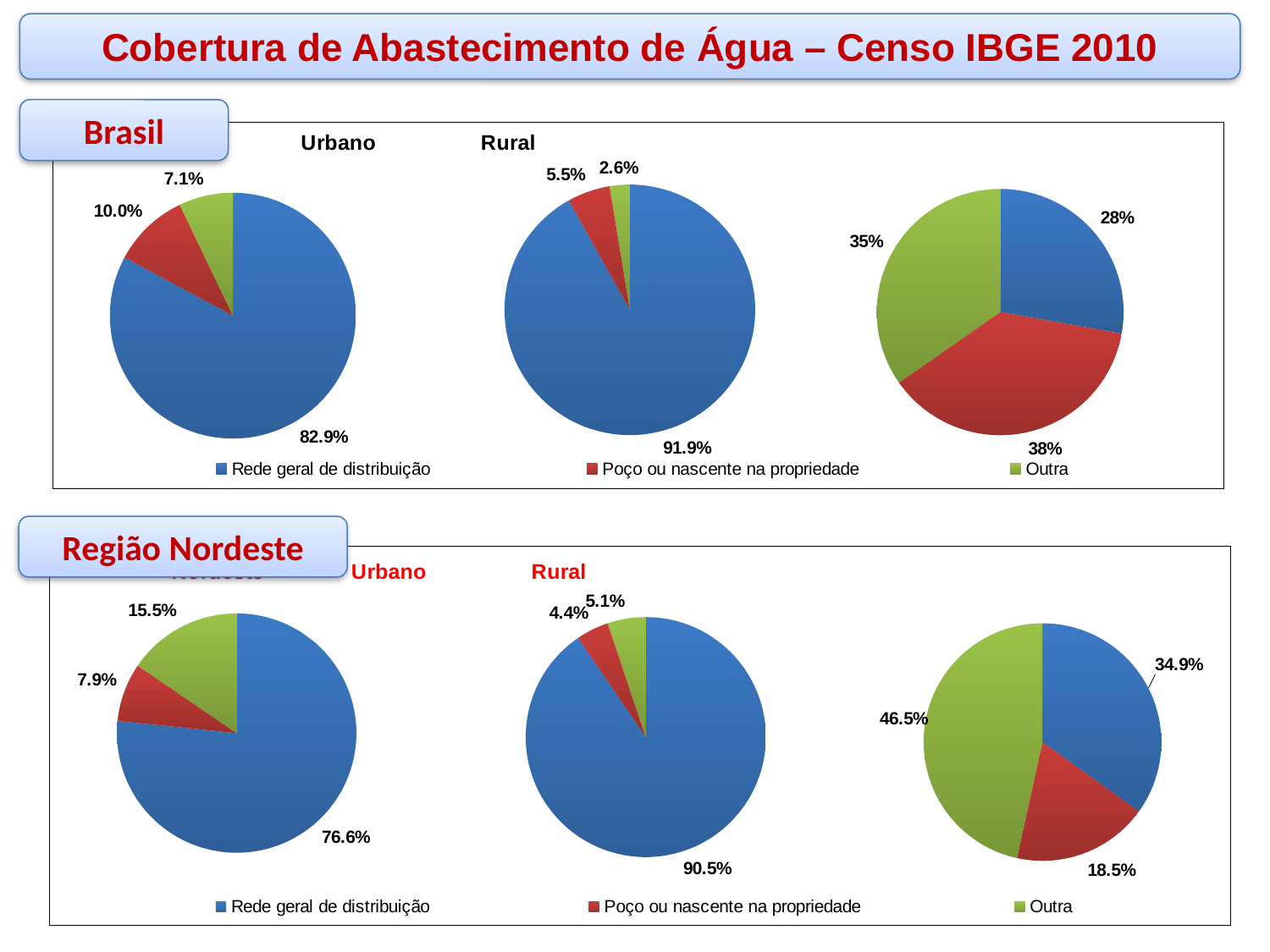
In the Brasil Urbano pie chart, what share is labelled for Rede geral de distribuição? 82.9% In the Região Nordeste Urbano pie chart, what share is labelled for Outra? 15.5% In the rightmost pie chart of the Região Nordeste row, what share is labelled for Outra? 46.5% In the rightmost pie chart of the Brasil row, which category has the largest slice? Poço ou nascente na propriedade In the Brasil Urbano pie chart, what is the difference between the Poço ou nascente na propriedade share and the Outra share? 2.9% What type of chart is used for the Brasil Urbano data? Pie chart Which is larger: the Rede geral de distribuição share in the Brasil Rural pie chart or in the Região Nordeste Rural pie chart? Brasil Rural In the rightmost pie chart of the Região Nordeste row, which category has the smallest slice? Poço ou nascente na propriedade How many slices does the Região Nordeste Urbano pie chart have? 3 In the Brasil Rural pie chart, what share is labelled for Poço ou nascente na propriedade? 5.5% How many entries does the legend below the Brasil row list? 3 In the Região Nordeste Rural pie chart, what share is labelled for Rede geral de distribuição? 90.5%